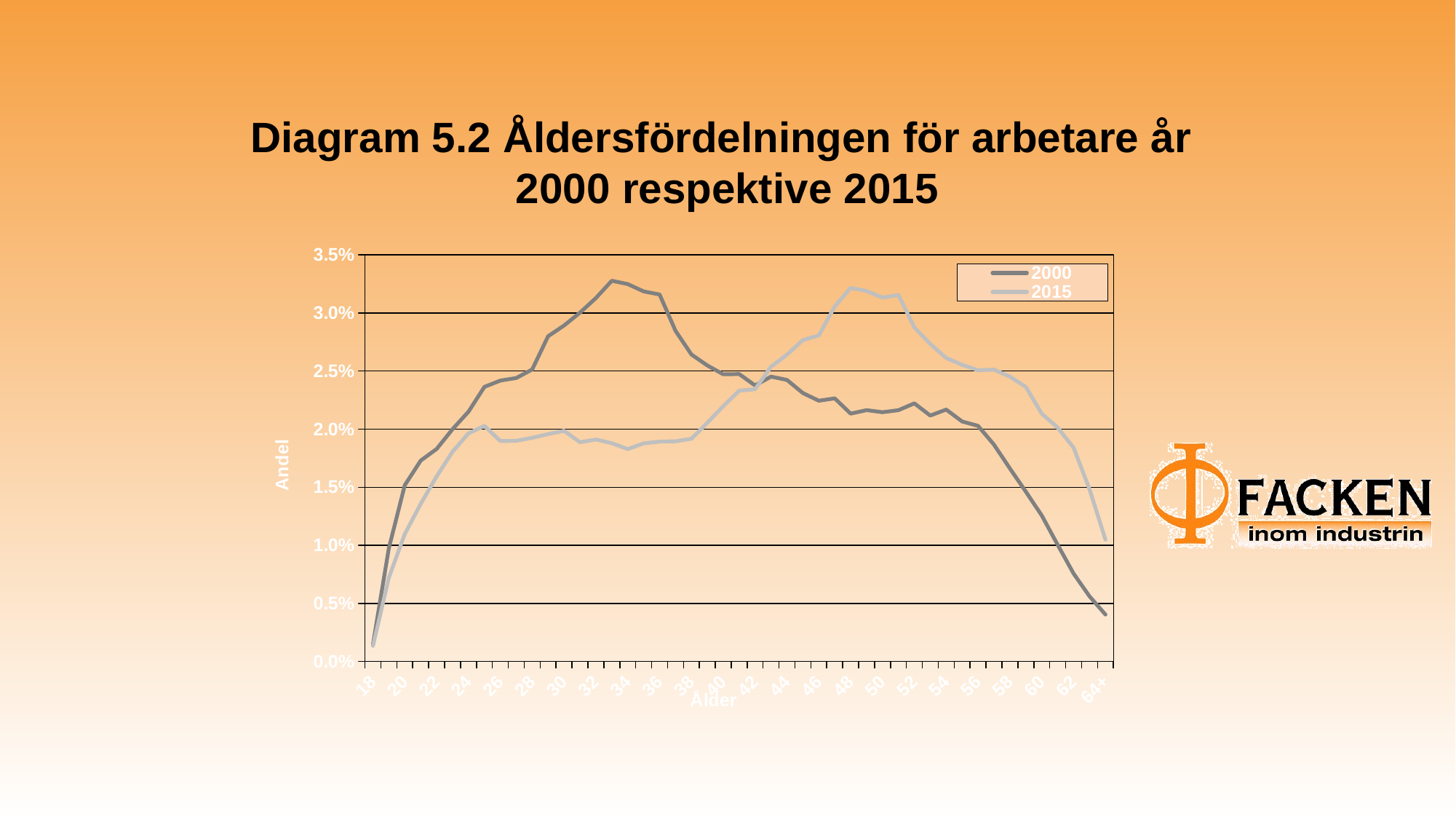
What are the two series named in the legend? 2000 and 2015 At age 30, which series has the higher value, 2000 or 2015? 2000 Does the 2015 series rise or fall between age 50 and 64+? fall What kind of chart is shown on the slide? line chart Is the value for the 2015 series at age 33 greater or less than 2.0%? less At age 50, which series has the higher value, 2000 or 2015? 2015 What is the title of the chart? Diagram 5.2 Åldersfördelningen för arbetare år 2000 respektive 2015 Does the 2000 series rise or fall between age 18 and age 33? rise Is the value for the 2015 series at age 48 greater or less than 3.0%? greater How many series does the legend list? 2 Is the value for the 2000 series at age 62 greater or less than 1.0%? less